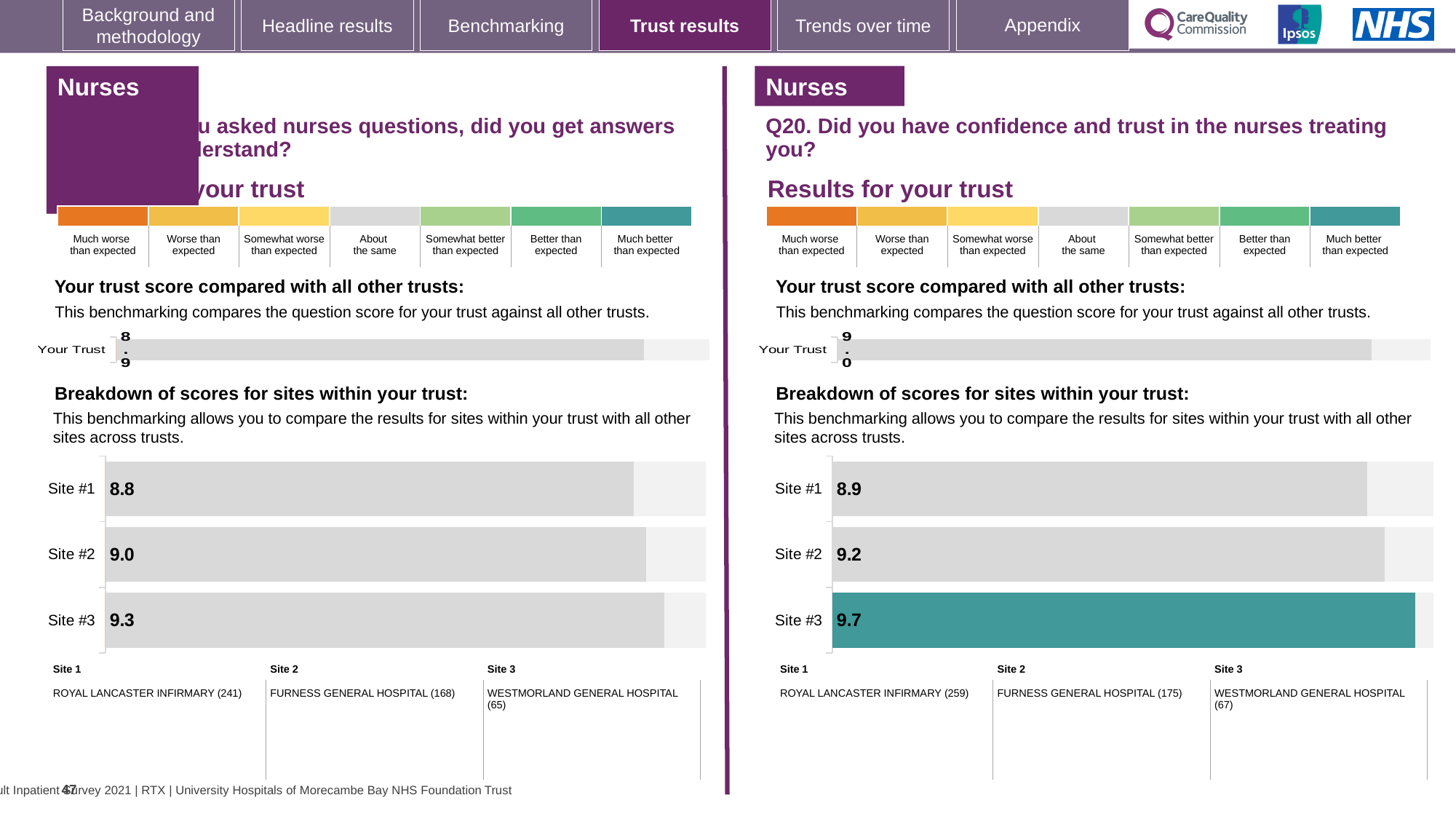
On the left-hand 'Breakdown of scores for sites within your trust' chart, what is the difference between the scores for Site #2 and Site #1? 0.2 On the right-hand Q20 'Breakdown of scores for sites within your trust' chart, which site's bar is coloured teal rather than grey? Site #3 How many sites are shown on the right-hand Q20 'Breakdown of scores for sites within your trust' chart? 3 On the right-hand Q20 'Breakdown of scores for sites within your trust' chart, which site has the highest score? Site #3 On the right-hand Q20 'Breakdown of scores for sites within your trust' chart, what is the difference between the scores for Site #3 and Site #1? 0.8 On the right-hand Q20 'Breakdown of scores for sites within your trust' chart, do the scores rise or fall from Site #1 to Site #3? Rise On the right-hand Q20 'Your trust score compared with all other trusts' chart, what is the score for Your Trust? 9.0 On the left-hand 'Breakdown of scores for sites within your trust' chart, which site has the lowest score? Site #1 What kind of chart is the left-hand 'Breakdown of scores for sites within your trust' chart? Bar chart On the left-hand 'Breakdown of scores for sites within your trust' chart, what is the score for Site #3? 9.3 On the left-hand 'Breakdown of scores for sites within your trust' chart, which is larger: the score for Site #2 or Site #3? Site #3 On the right-hand Q20 'Breakdown of scores for sites within your trust' chart, what is the score for Site #2? 9.2